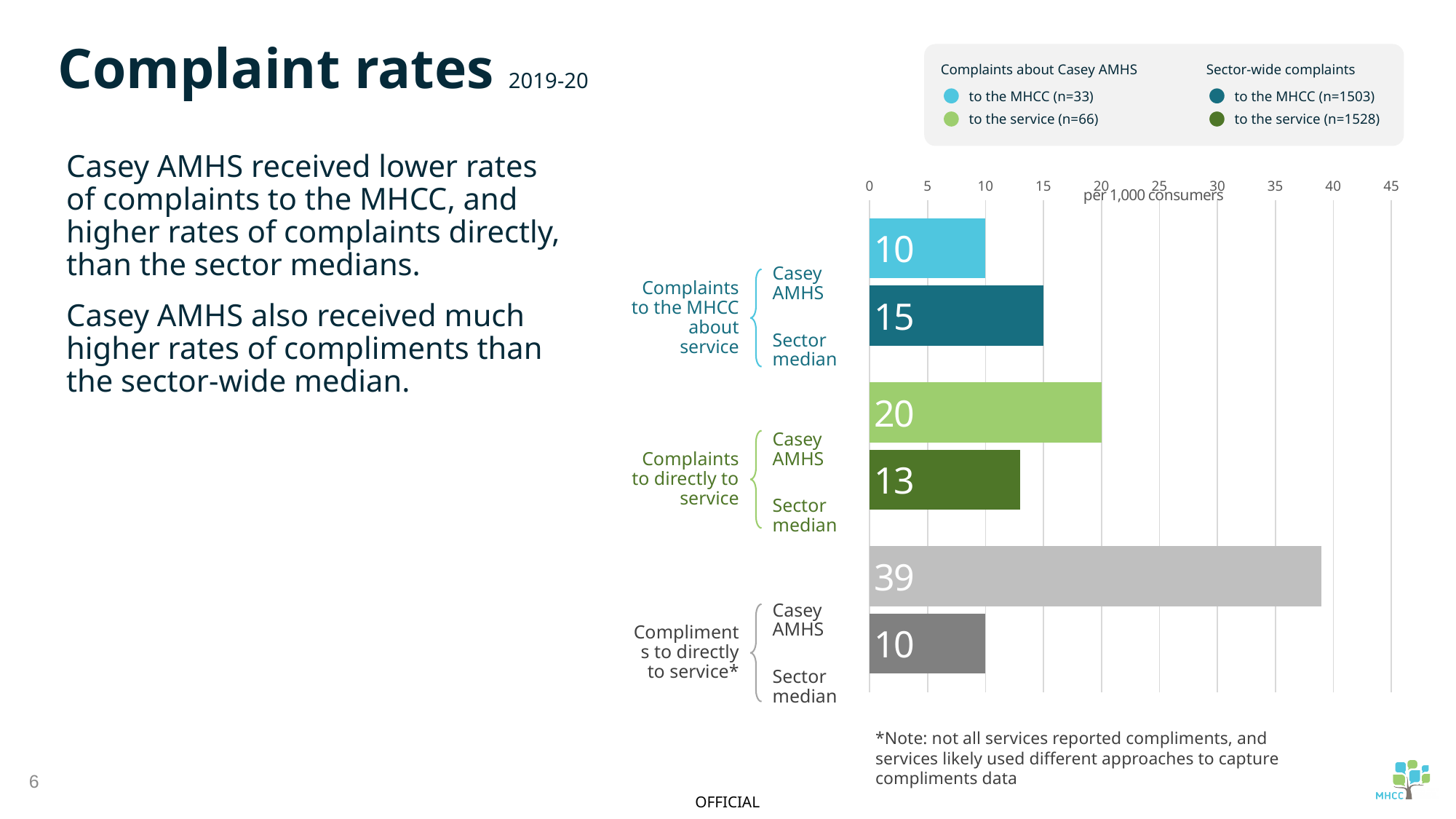
How many bars are plotted on the chart? 6 What is the rate of complaints to the MHCC about service for Casey AMHS, per 1,000 consumers? 10 What is the difference between the Casey AMHS and sector median rates of complaints directly to service? 7 What is the difference between the Casey AMHS and sector median rates of compliments directly to service? 29 For complaints to the MHCC about service, which is larger: Casey AMHS or the sector median? Sector median What unit is the horizontal axis of the chart measured in? per 1,000 consumers What is the sector median rate of complaints to the MHCC about service? 15 What is the rate of complaints directly to service for Casey AMHS? 20 What is the sector median rate of complaints directly to service? 13 What kind of chart is shown on the slide? Bar chart What is the rate of compliments directly to service for Casey AMHS? 39 Which bar has the highest value on the chart? Compliments to directly to service, Casey AMHS